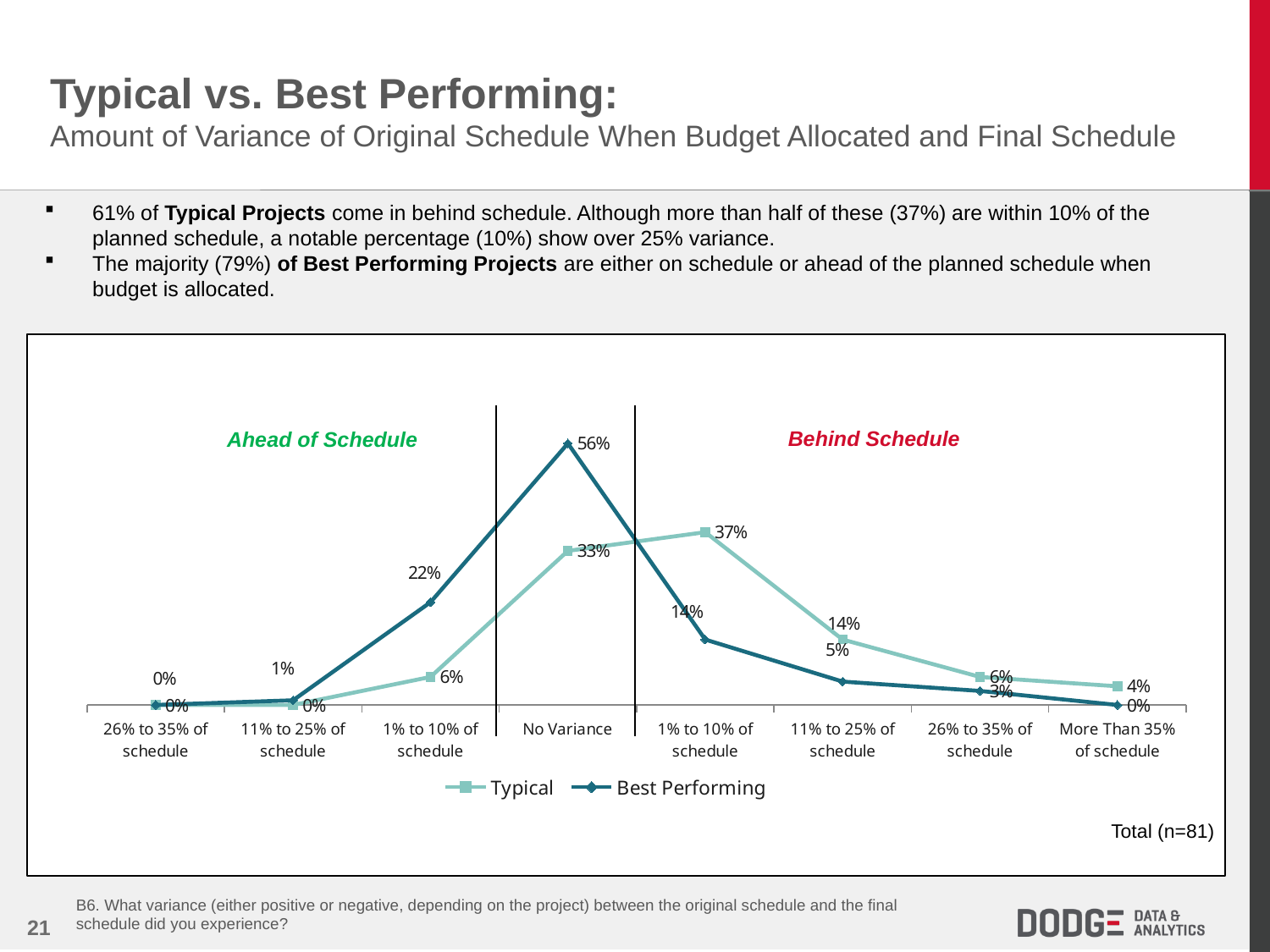
What sample size is noted on the chart? n=81 How many categories are shown on the x axis? 8 Which category has the highest value for the Best Performing series? No Variance What is the value for Best Performing at No Variance? 56% What kind of chart is shown on the slide? Line chart What is the value for Best Performing at 1% to 10% of schedule in the Ahead of Schedule section? 22% At No Variance, what is the difference between the Best Performing value and the Typical value? 23 percentage points What is the value for Typical at More Than 35% of schedule? 4% Which category has the highest value for the Typical series? 1% to 10% of schedule (Behind Schedule) What is the value for Typical at 1% to 10% of schedule in the Behind Schedule section? 37% At 11% to 25% of schedule in the Behind Schedule section, which series has the larger value, Typical or Best Performing? Typical How many series does the legend list? 2